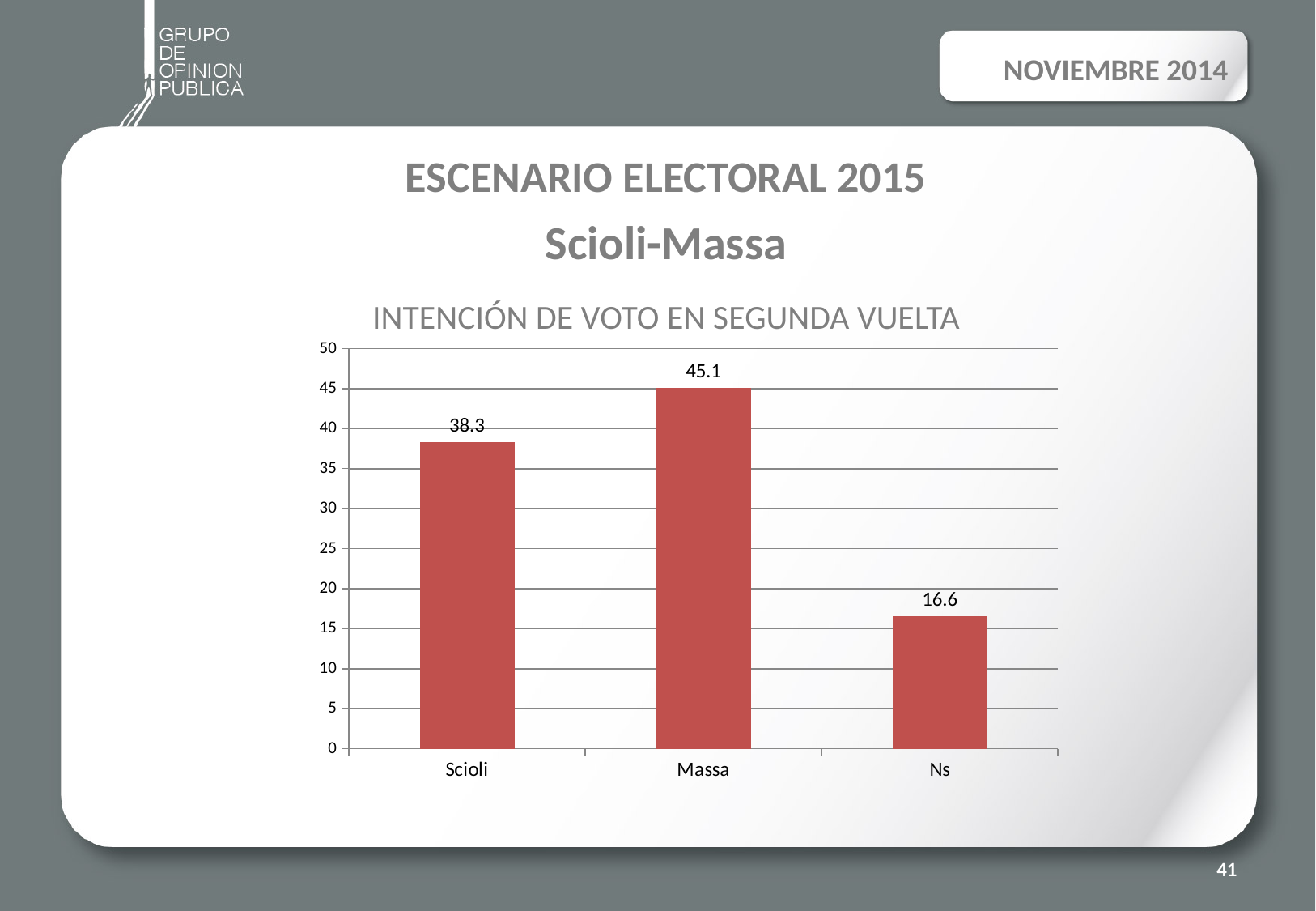
Which is larger, the value for Scioli or the value for Massa? Massa What is the value for Ns? 16.6 What kind of chart is shown on the slide? bar chart Is the value for Ns greater or less than 20? less Which category has the highest value? Massa Which category has the lowest value? Ns What is the difference between the values for Massa and Scioli? 6.8 What is the value for Massa? 45.1 What is the difference between the values for Scioli and Ns? 21.7 What is the value for Scioli? 38.3 How many categories are shown on the x axis? 3 What is the title of the chart? INTENCIÓN DE VOTO EN SEGUNDA VUELTA